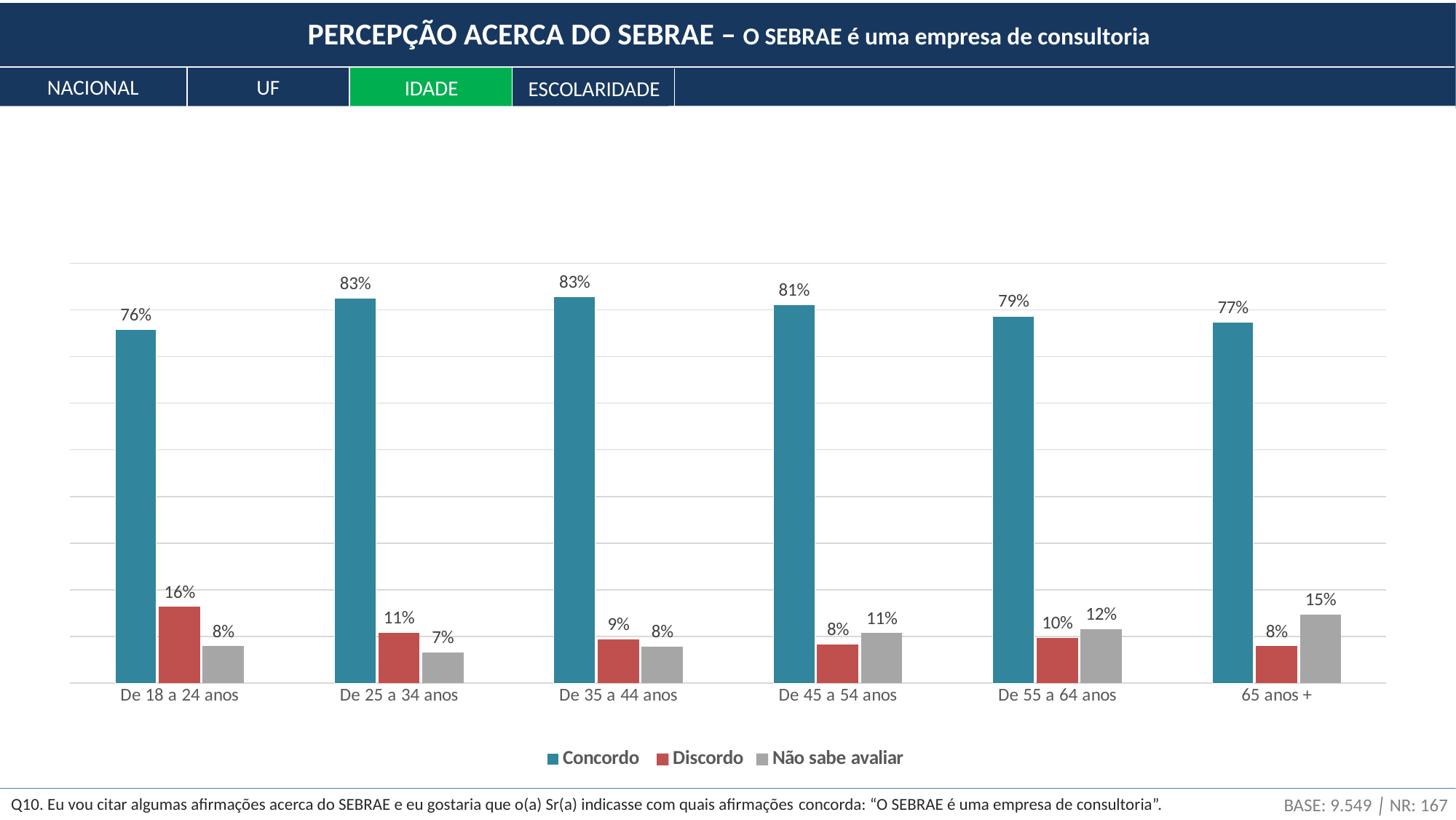
What kind of chart is shown on the slide? Bar chart How many age groups are shown on the x axis? 6 Which age group has the highest Discordo value? De 18 a 24 anos What is the Concordo value for 65 anos +? 77% What is the Concordo value for De 18 a 24 anos? 76% What is the Não sabe avaliar value for De 55 a 64 anos? 12% How many series does the legend list? 3 Which is larger: the Discordo value for De 18 a 24 anos or the Não sabe avaliar value for 65 anos +? Discordo for De 18 a 24 anos What is the Discordo value for De 25 a 34 anos? 11% What is the difference between the Concordo values for De 35 a 44 anos and De 45 a 54 anos? 2% Which age group has the lowest Concordo value? De 18 a 24 anos Which age group has the highest Não sabe avaliar value? 65 anos +